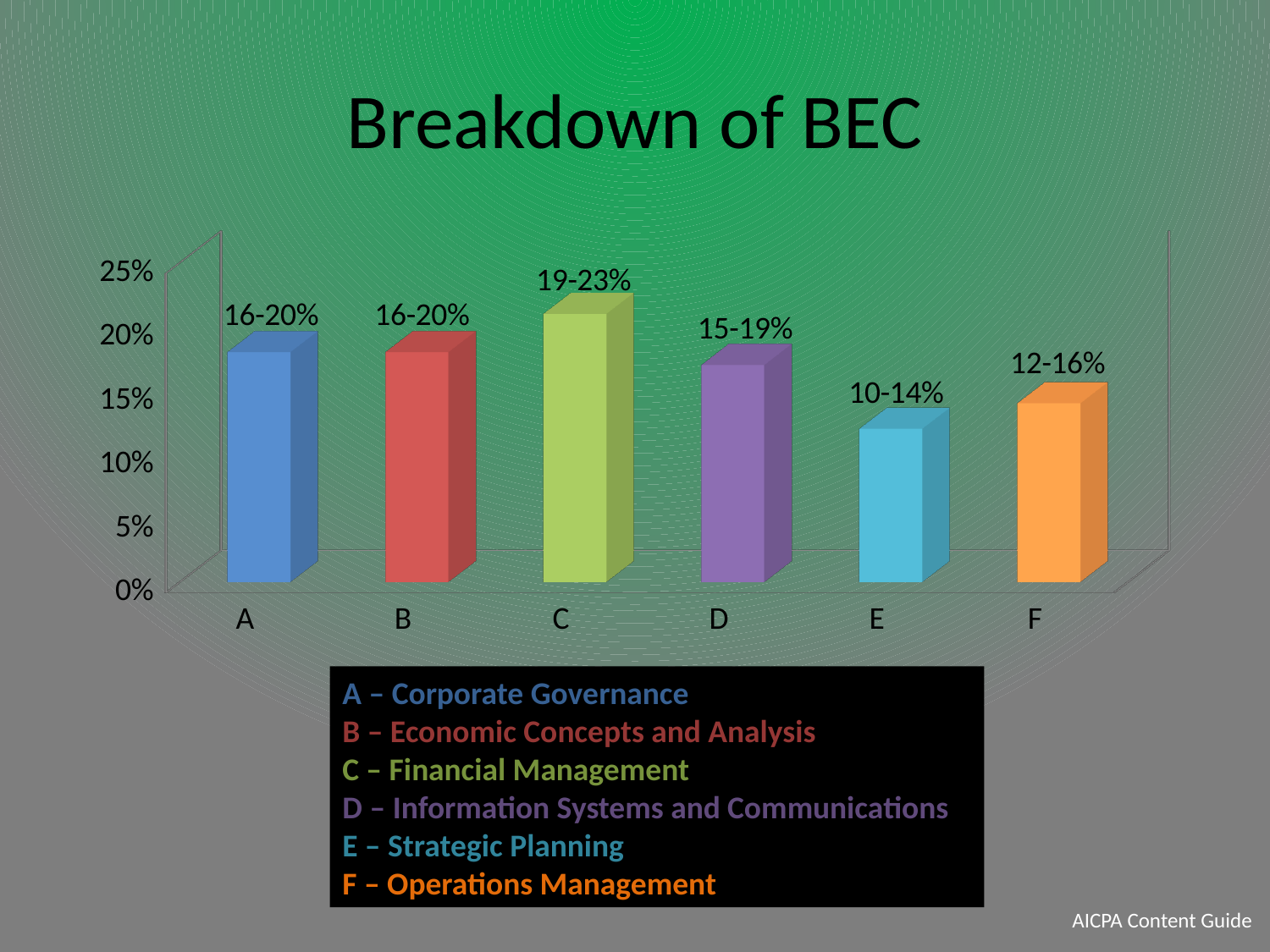
What is the data label shown for category E? 10-14% Which category has the tallest bar? C Is the value for category E greater or less than 15%? less According to the key below the chart, what does category C stand for? Financial Management Which bar is taller, D or F? D How many categories are shown on the x axis? 6 What kind of chart is shown on the slide? Bar chart Is the value for category A greater or less than 15%? greater What is the data label shown for category F? 12-16% Which category has the shortest bar? E What is the data label shown for category D? 15-19% What is the data label shown for category C? 19-23%